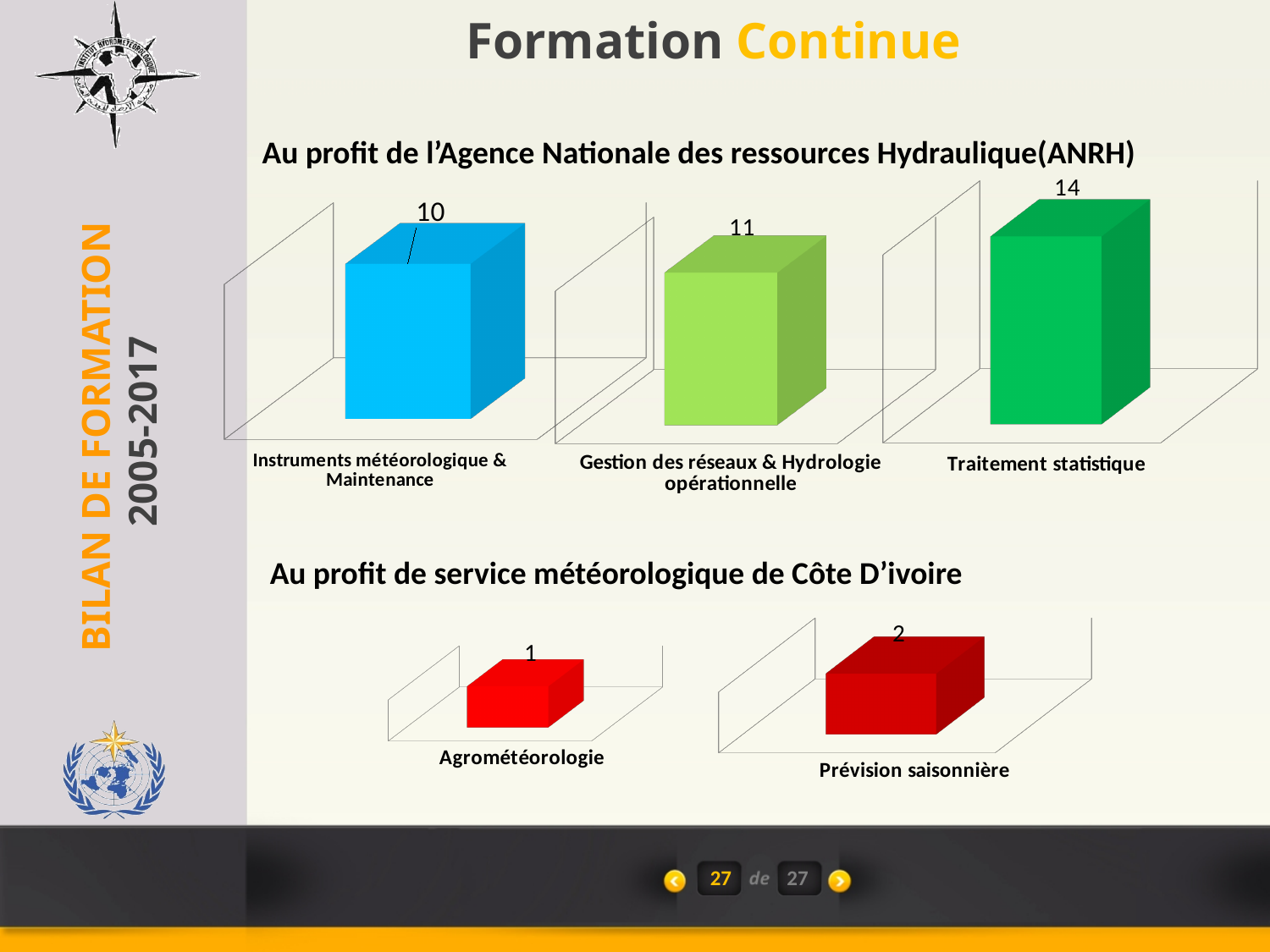
In the ANRH chart, how many categories are shown? 3 In the ANRH chart, which category has the highest value? Traitement statistique In the ANRH chart, what is the value for Gestion des réseaux & Hydrologie opérationnelle? 11 In the Côte D'ivoire chart, what is the value for Prévision saisonnière? 2 In the ANRH chart, do the values rise or fall from left to right? Rise In the ANRH chart, which category has the lowest value? Instruments météorologique & Maintenance In the Côte D'ivoire chart, what is the value for Agrométéorologie? 1 In the ANRH chart, what is the value for Instruments météorologique & Maintenance? 10 What kind of chart is the ANRH chart? Bar chart In the ANRH chart, what is the difference between Traitement statistique and Instruments météorologique & Maintenance? 4 In the ANRH chart, what is the value for Traitement statistique? 14 In the Côte D'ivoire chart, which is larger, Agrométéorologie or Prévision saisonnière? Prévision saisonnière